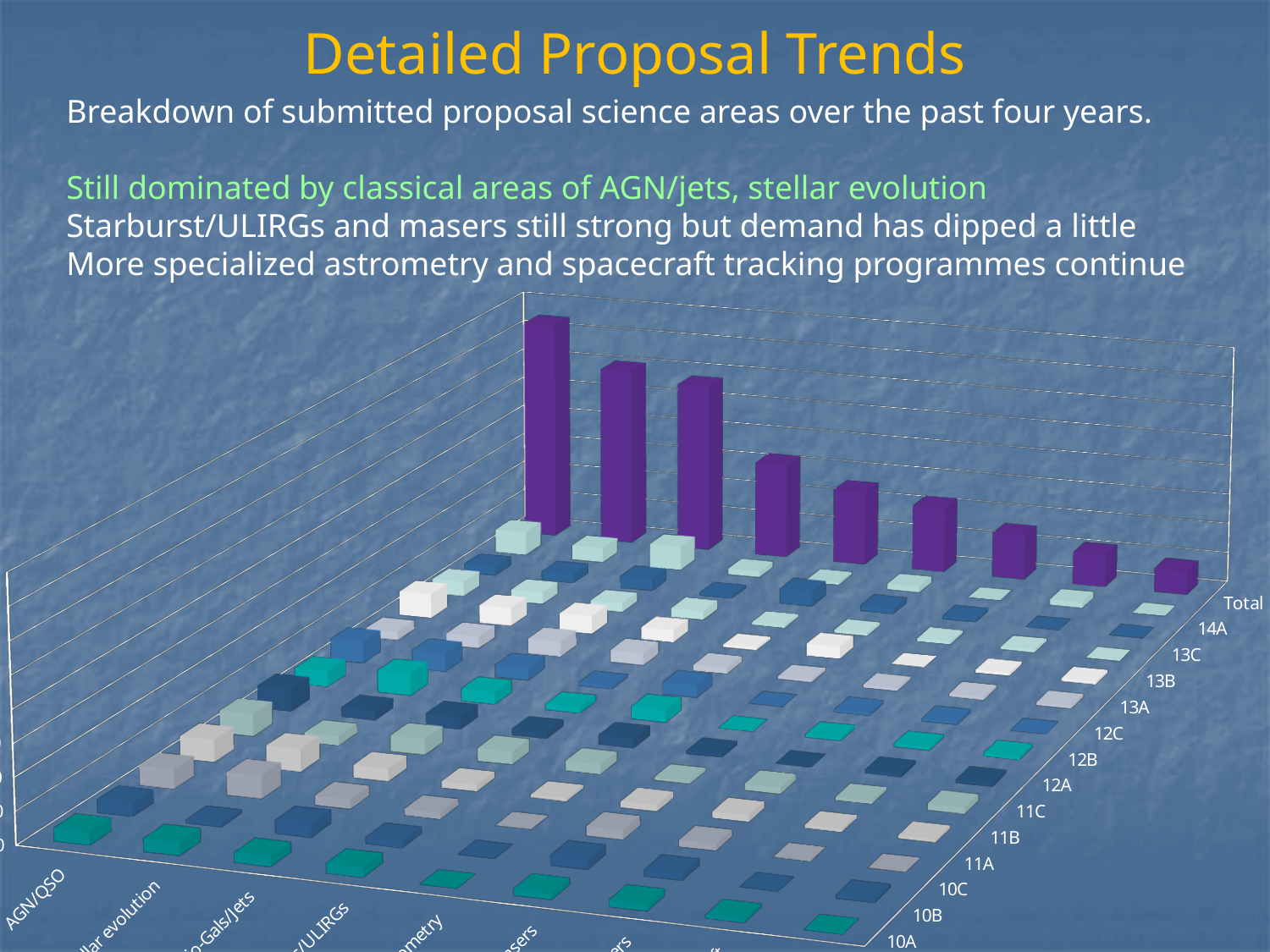
What is the first depth-axis label (the front-most row of bars)? 10A What colour are the bars for the Total series? purple Which is larger: the Total for AGN/QSO or the Total for the rightmost science area? AGN/QSO How many labels are listed along the depth axis (from 10A to Total)? 14 Which science area has the tallest Total bar? AGN/QSO What is the last label on the depth axis, after 14A? Total What kind of chart is shown on the slide? bar chart How many purple Total bars are plotted? 9 Do the Total bars rise or fall moving from AGN/QSO towards the right-hand categories? fall